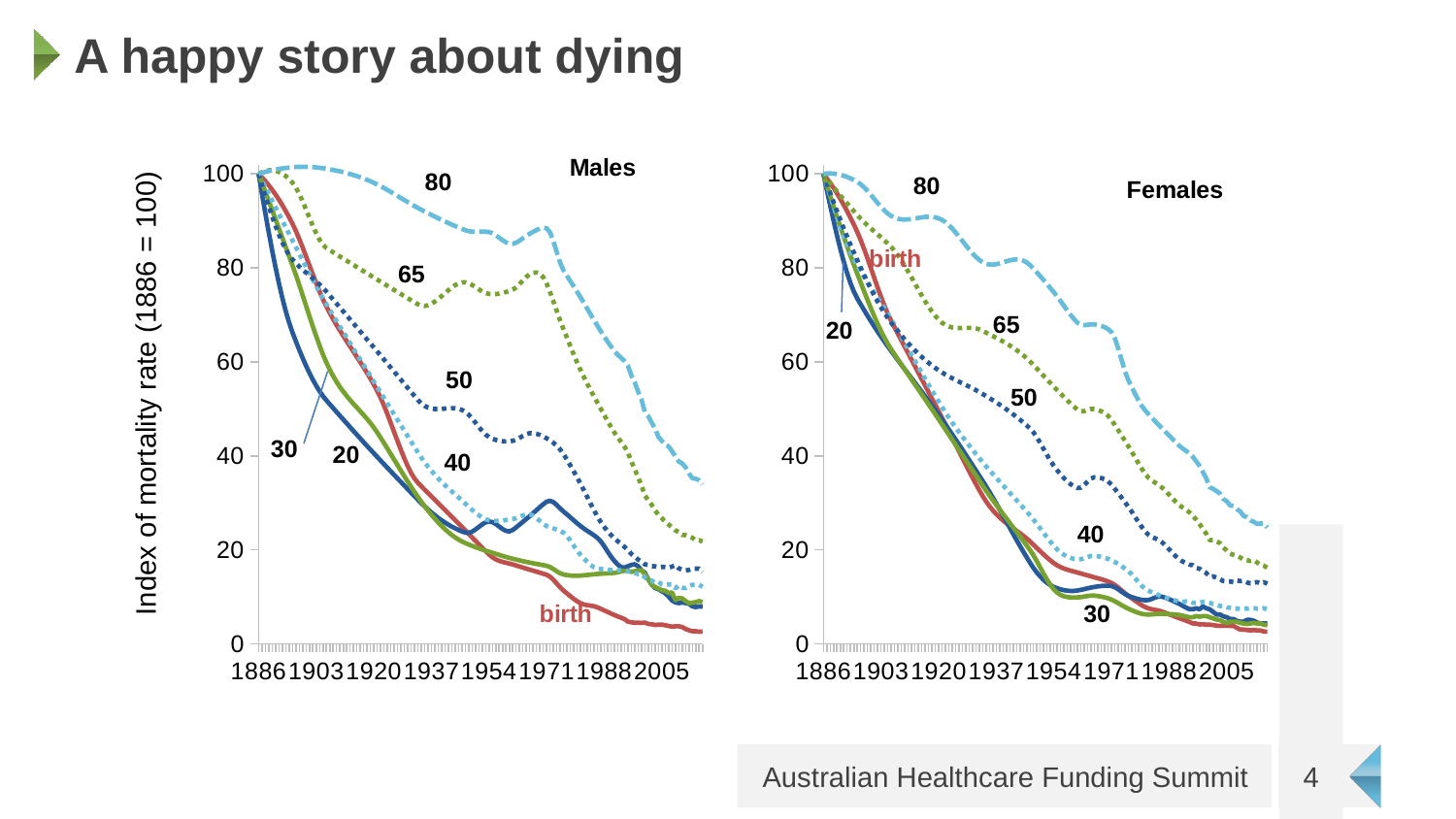
On the Males chart, which age group has the highest mortality index at the latest year shown? 80 What is the index value of every line in 1886 on the Females chart? 100 On the Males chart in 1971, which is higher: the line for age 80 or the line for age 50? 80 On the Males chart, is the value for age 65 in 1937 greater or less than 60? greater On the Males chart, which age group has the lowest mortality index at the latest year shown? birth On the Males chart, is the value for age 80 at the latest year greater or less than 40? less What type of chart is used for the Males and Females panels on this slide? Line chart What is the label on the vertical axis of the charts? Index of mortality rate (1886 = 100) How many age-group lines are plotted on the Males chart? 7 On the Females chart, which age group has the highest mortality index at the latest year shown? 80 On the Females chart, is the value for age 80 in 1920 greater or less than 80? greater On the Males chart, do the mortality index values generally rise or fall from 1886 to the latest year? Fall